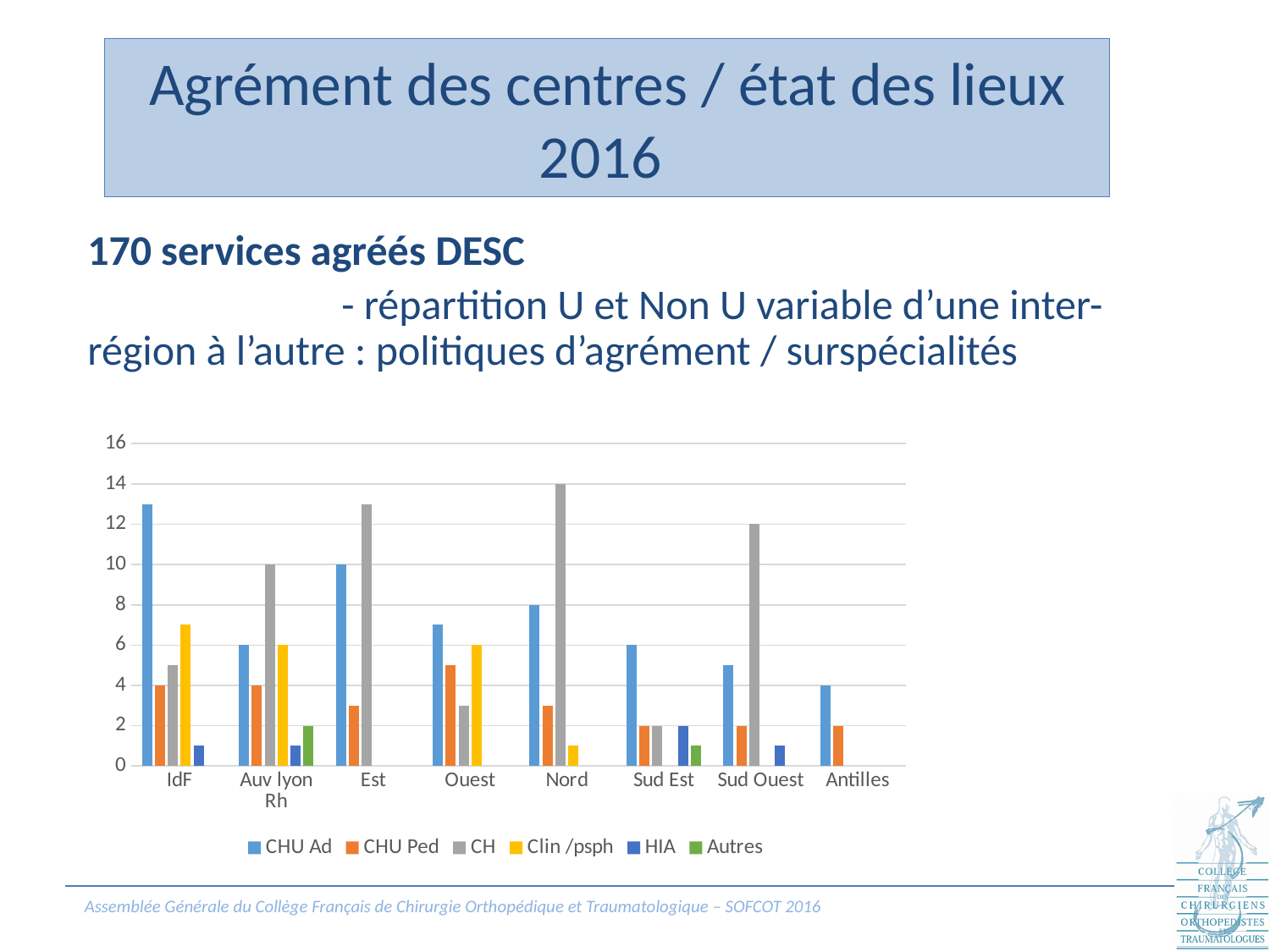
Is the CHU Ad value for IdF greater or less than 12? greater What is the value of CHU Ad for Antilles? 4 How many inter-regions (categories) are shown on the x axis of the chart? 8 What is the value of CHU Ad for Est? 10 What is the difference between the CH value and the CHU Ad value for Nord? 6 What colour represents the CH series in the legend? grey What kind of chart is shown on the slide? bar chart Is the CHU Ad value for Ouest greater or less than 8? less What is the value of CH for Nord? 14 For Sud Ouest, which is larger: CH or CHU Ad? CH How many series does the chart legend list? 6 Which inter-region has the highest CH value? Nord